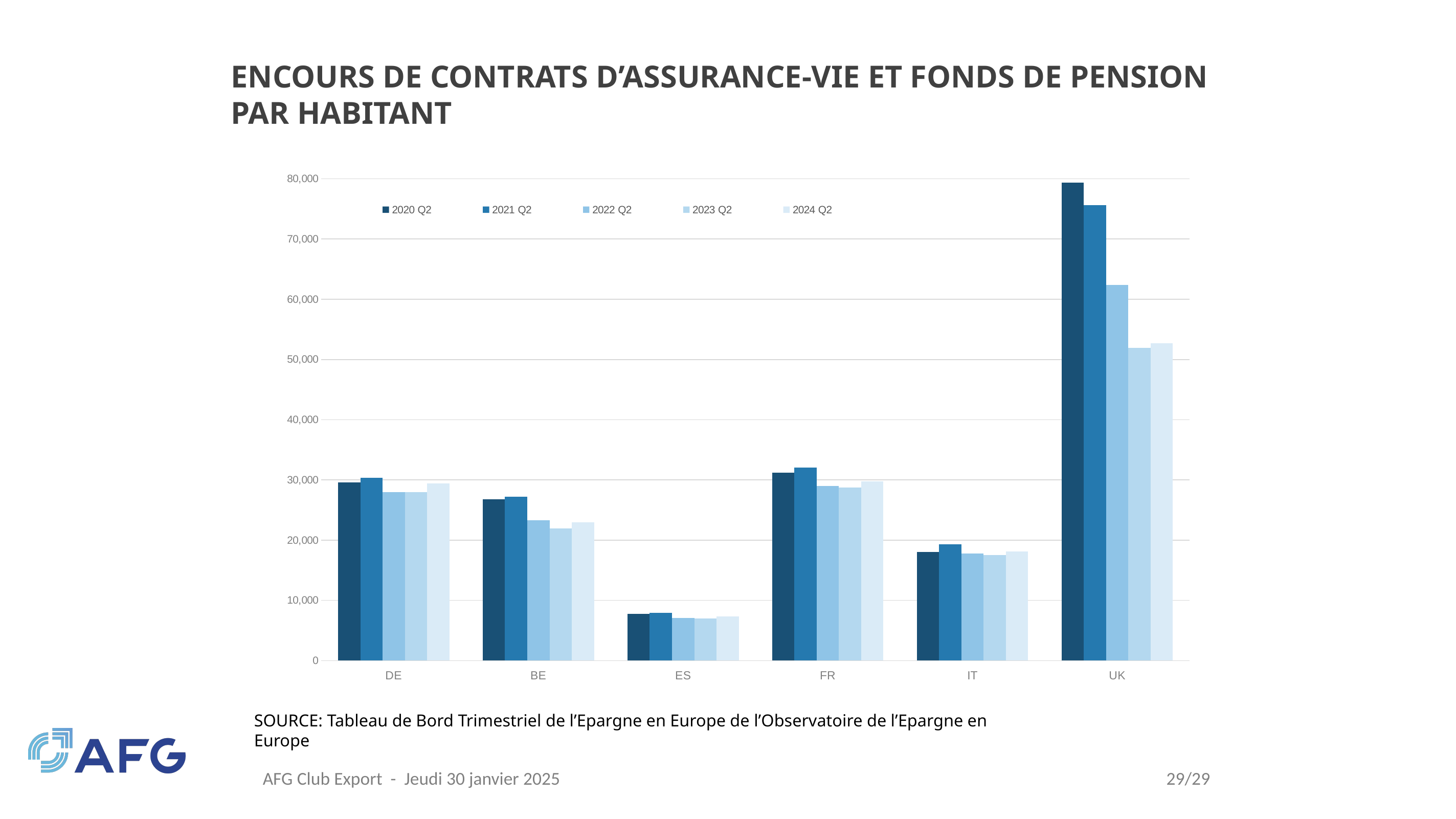
Which is larger for 2021 Q2, FR or DE? FR What is the first entry in the chart's legend? 2020 Q2 Which country has the highest value for 2020 Q2? UK How many countries are shown on the x axis of the chart? 6 For UK, which is larger, the 2022 Q2 value or the 2023 Q2 value? 2022 Q2 Which country has the lowest value for 2024 Q2? ES Is the value for ES in 2021 Q2 greater or less than 10,000? less How many series does the legend list? 5 Is the value for IT in 2020 Q2 greater or less than 20,000? less Is the value for UK in 2020 Q2 greater or less than 70,000? greater What kind of chart is shown on the slide? bar chart Do the UK values rise or fall from 2020 Q2 to 2023 Q2? fall